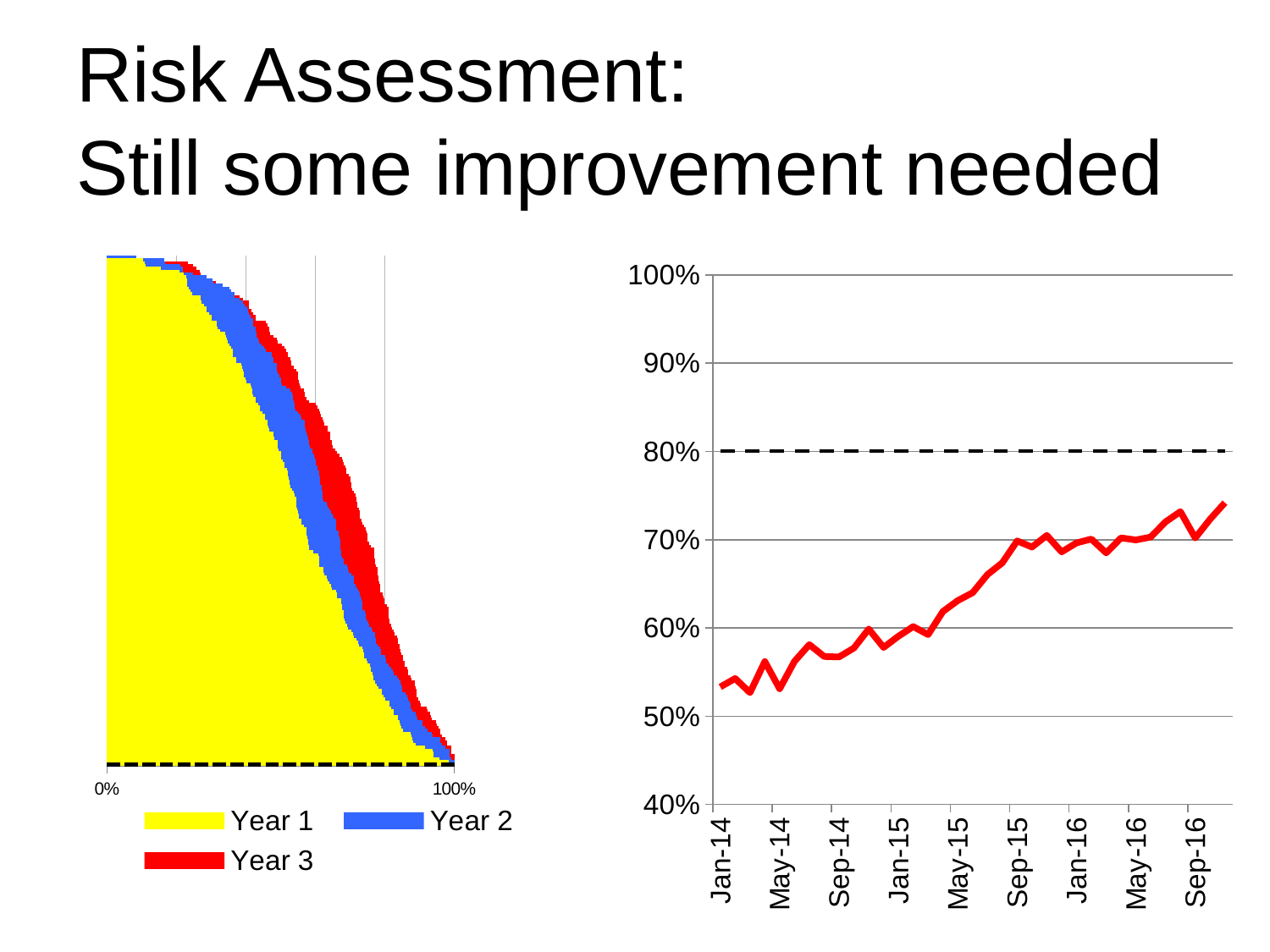
In the left chart, what colour is the Year 3 series? red How many series does the legend of the left chart list? 3 In the right chart, does the line ever reach the 80% dashed line? no In the right chart, is the value for May-15 greater or less than 70%? less In the right chart, do the values generally rise or fall from Jan-14 to Sep-16? rise How many date labels are shown on the x axis of the right chart? 9 In the left chart, which series is shown in yellow? Year 1 What kind of chart is the chart on the left of the slide? bar chart In the right chart, which is larger, the value for Jan-14 or the value for Sep-16? Sep-16 In the right chart, is the value for Jan-14 greater or less than 60%? less What kind of chart is the chart on the right of the slide? line chart